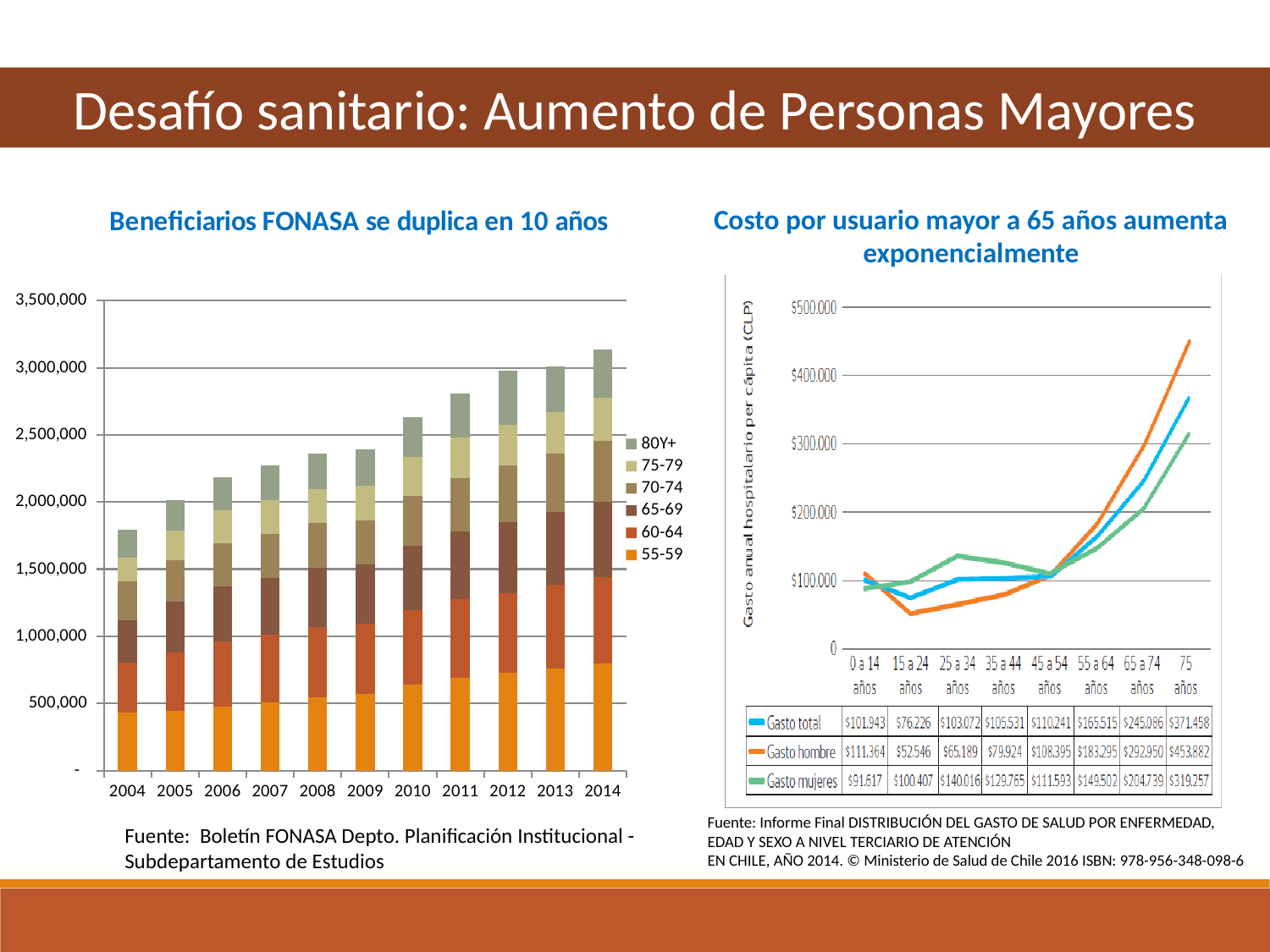
What kind of chart is the left chart titled 'Beneficiarios FONASA se duplica en 10 años'? Stacked bar chart In the left chart 'Beneficiarios FONASA se duplica en 10 años', do the total bar heights rise or fall from 2004 to 2014? rise How many years are shown on the x axis of the left chart 'Beneficiarios FONASA se duplica en 10 años'? 11 In the right chart 'Costo por usuario mayor a 65 años aumenta exponencialmente', what is the Gasto hombre for the 15 a 24 años group? $52.546 How many series does the legend of the left chart 'Beneficiarios FONASA se duplica en 10 años' list? 6 In the left chart 'Beneficiarios FONASA se duplica en 10 años', is the total for 2014 greater or less than 3,000,000? greater In the right chart 'Costo por usuario mayor a 65 años aumenta exponencialmente', what is the Gasto mujeres for the 25 a 34 años group? $140.016 In the right chart 'Costo por usuario mayor a 65 años aumenta exponencialmente', which age group has the highest Gasto hombre? 75 años In the right chart 'Costo por usuario mayor a 65 años aumenta exponencialmente', how many series does the legend list? 3 In the right chart 'Costo por usuario mayor a 65 años aumenta exponencialmente', which is larger for the 65 a 74 años group, Gasto hombre or Gasto mujeres? Gasto hombre In the right chart 'Costo por usuario mayor a 65 años aumenta exponencialmente', what is the Gasto total for the 75 años group? $371.458 In the left chart 'Beneficiarios FONASA se duplica en 10 años', which year has the tallest stacked bar? 2014